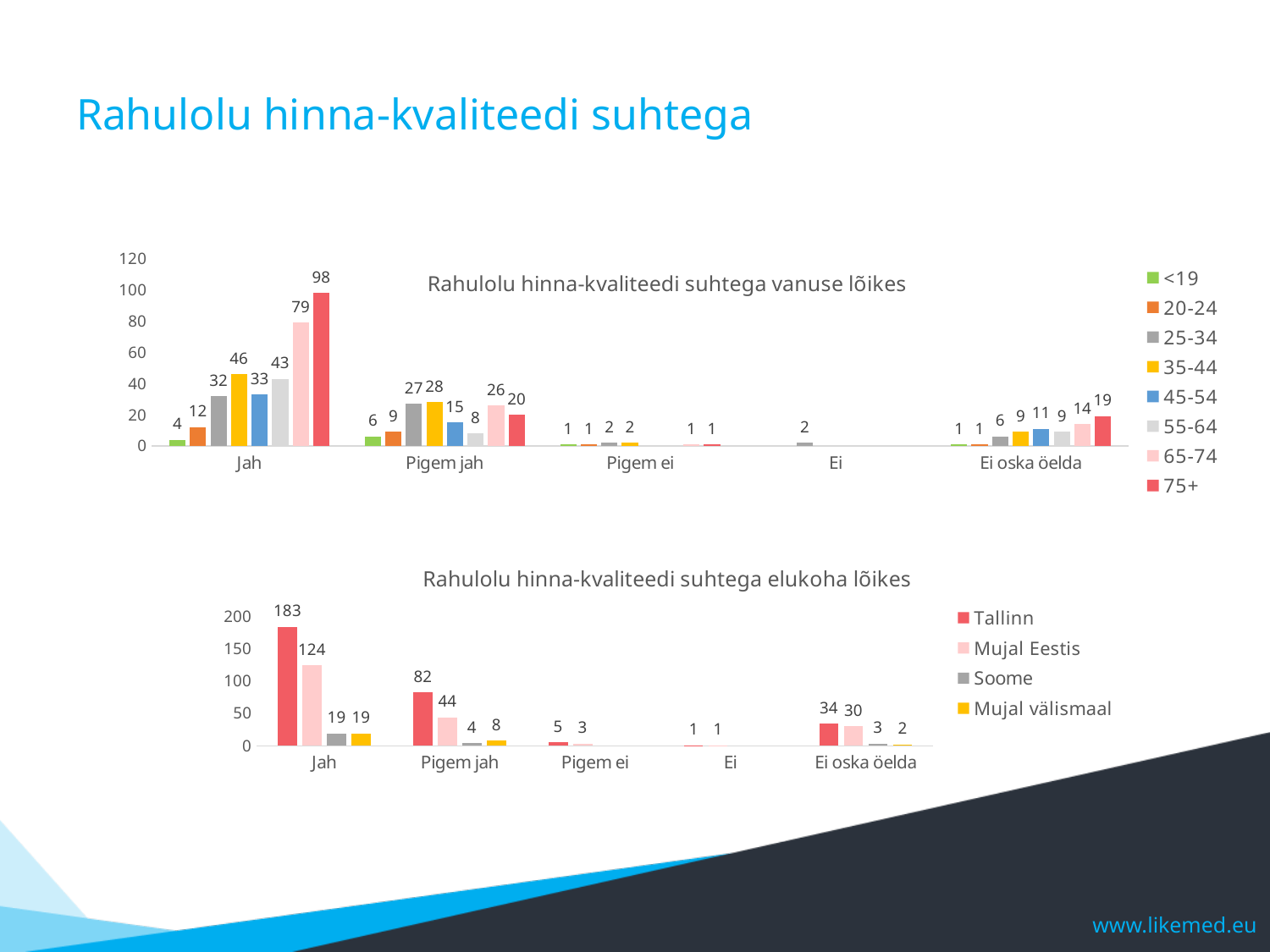
In the chart 'Rahulolu hinna-kvaliteedi suhtega elukoha lõikes', what is the value for Tallinn in the 'Jah' category? 183 In the chart 'Rahulolu hinna-kvaliteedi suhtega vanuse lõikes', is the value for 65-74 in the 'Jah' category greater or less than 60? greater In the chart 'Rahulolu hinna-kvaliteedi suhtega elukoha lõikes', which is larger in the 'Pigem jah' category: Tallinn or Mujal Eestis? Tallinn What type of chart is 'Rahulolu hinna-kvaliteedi suhtega elukoha lõikes'? Bar chart How many categories are shown on the x axis of the chart 'Rahulolu hinna-kvaliteedi suhtega elukoha lõikes'? 5 How many series does the legend of the chart 'Rahulolu hinna-kvaliteedi suhtega vanuse lõikes' list? 8 In the chart 'Rahulolu hinna-kvaliteedi suhtega vanuse lõikes', what is the difference between the 75+ and 65-74 values in the 'Jah' category? 19 In the chart 'Rahulolu hinna-kvaliteedi suhtega elukoha lõikes', what is the difference between the Tallinn and Mujal Eestis values in the 'Jah' category? 59 In the chart 'Rahulolu hinna-kvaliteedi suhtega vanuse lõikes', which age series has the highest value in the 'Jah' category? 75+ In the chart 'Rahulolu hinna-kvaliteedi suhtega vanuse lõikes', what is the value for the 75+ series in the 'Jah' category? 98 In the chart 'Rahulolu hinna-kvaliteedi suhtega elukoha lõikes', what is the value for Mujal Eestis in the 'Ei oska öelda' category? 30 In the chart 'Rahulolu hinna-kvaliteedi suhtega vanuse lõikes', what is the value for the 35-44 series in the 'Pigem jah' category? 28